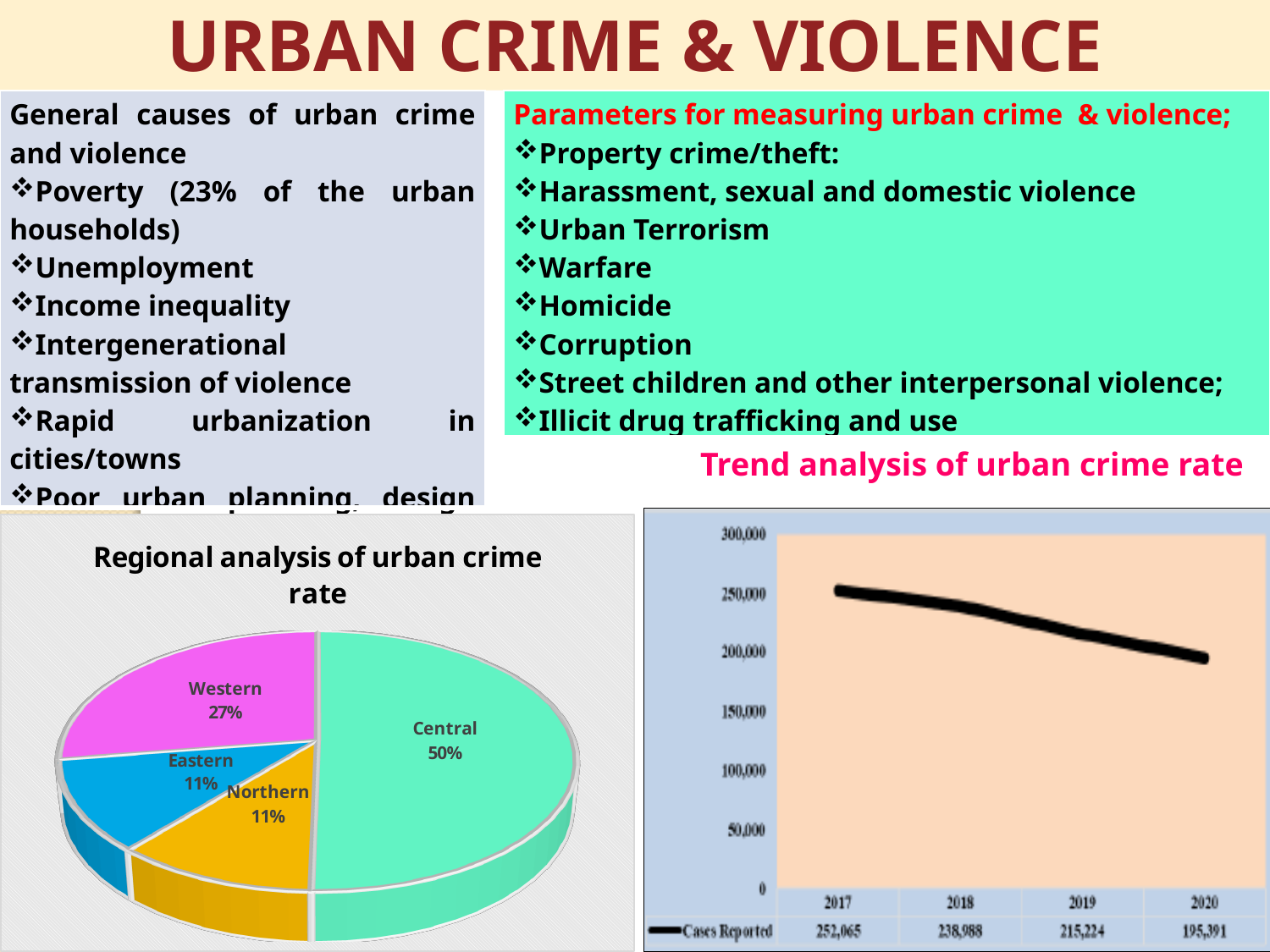
What kind of chart is 'Regional analysis of urban crime rate'? Pie chart What kind of chart is 'Trend analysis of urban crime rate'? Line chart In the 'Regional analysis of urban crime rate' pie chart, what share does Central have? 50% In the 'Regional analysis of urban crime rate' pie chart, what is the difference between the Central and Western shares? 23% In the 'Trend analysis of urban crime rate' chart, how many cases were reported in 2017? 252,065 In the 'Trend analysis of urban crime rate' chart, how many cases were reported in 2020? 195,391 In the 'Regional analysis of urban crime rate' pie chart, how many regions are shown? 4 In the 'Regional analysis of urban crime rate' pie chart, which region has the largest share? Central In the 'Regional analysis of urban crime rate' pie chart, what share does Western have? 27% In the 'Trend analysis of urban crime rate' chart, what is the difference in cases reported between 2018 and 2019? 23,764 In the 'Trend analysis of urban crime rate' chart, do the cases reported rise or fall from 2017 to 2020? Fall In the 'Trend analysis of urban crime rate' chart, which year has the lowest number of cases reported? 2020